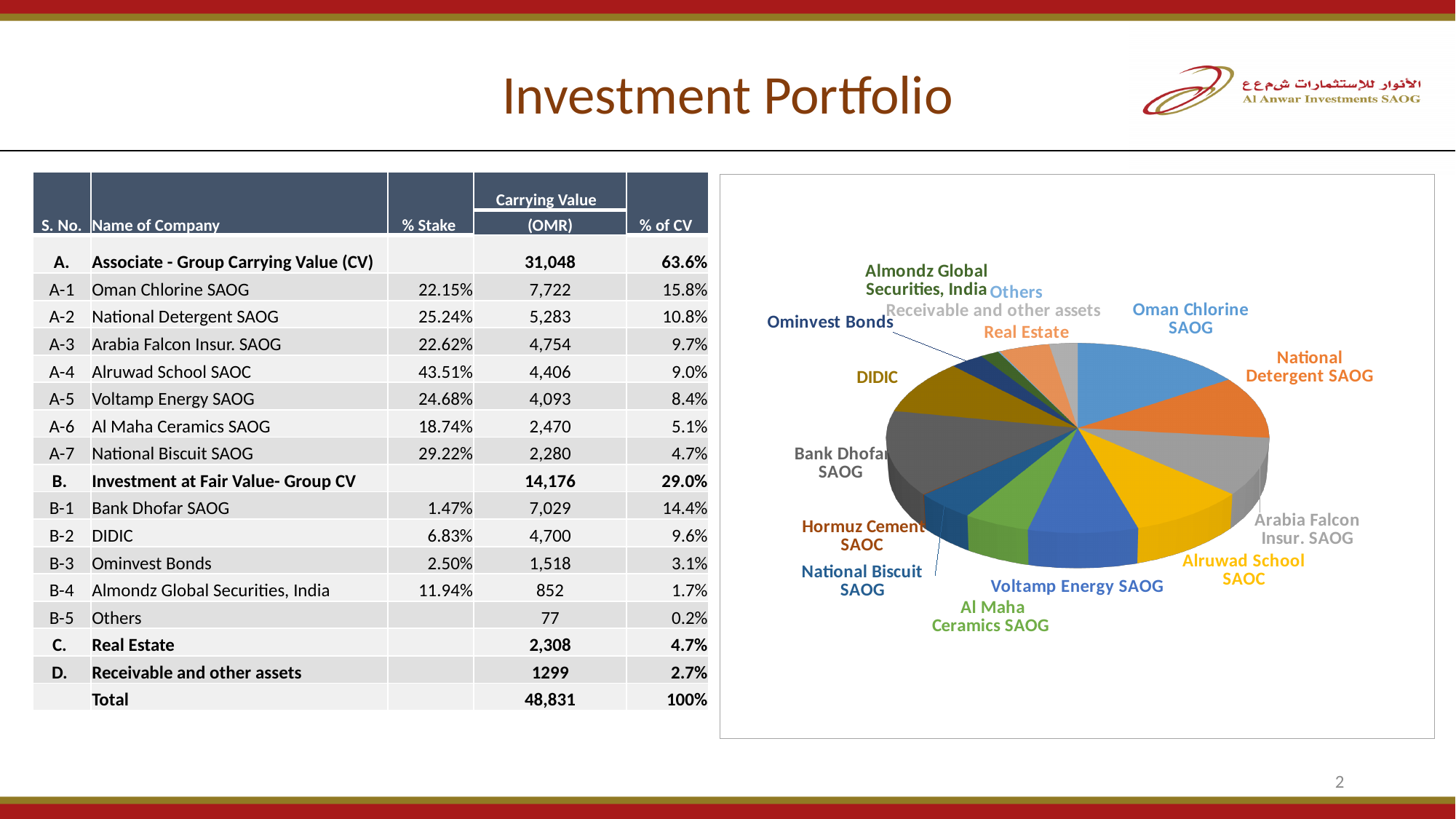
In the pie chart, which slice is larger: National Detergent SAOG or Real Estate? National Detergent SAOG According to the slide, what share of the carrying value does Oman Chlorine SAOG represent? 15.8% In the pie chart, which slice is larger: Oman Chlorine SAOG or Others? Oman Chlorine SAOG According to the slide, what share of the carrying value does Bank Dhofar SAOG represent? 14.4% How many slices are labelled in the pie chart? 15 According to the slide, what share of the carrying value does Real Estate represent? 4.7% What kind of chart is shown on the right side of the slide? pie chart Which slice of the pie chart is the smallest? Hormuz Cement SAOC What colour is the National Detergent SAOG slice in the pie chart? orange In the pie chart, which slice is larger: Bank Dhofar SAOG or Almondz Global Securities, India? Bank Dhofar SAOG What colour is the Oman Chlorine SAOG slice in the pie chart? blue